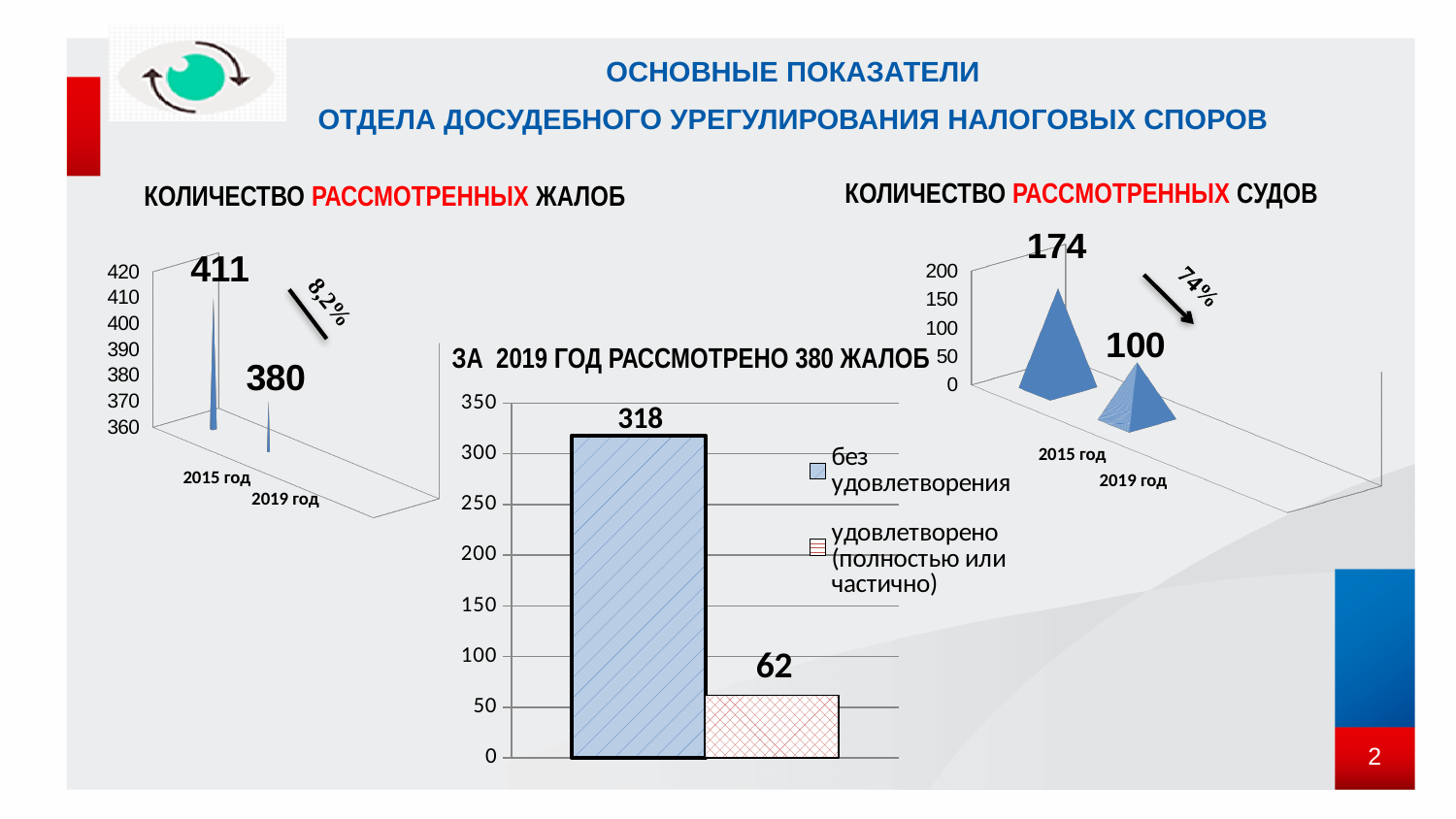
In the chart 'КОЛИЧЕСТВО РАССМОТРЕННЫХ ЖАЛОБ', what is the value for 2019 год? 380 What kind of chart is 'ЗА 2019 ГОД РАССМОТРЕНО 380 ЖАЛОБ'? bar chart In the chart 'КОЛИЧЕСТВО РАССМОТРЕННЫХ ЖАЛОБ', do the values rise or fall from 2015 год to 2019 год? fall In the chart 'ЗА 2019 ГОД РАССМОТРЕНО 380 ЖАЛОБ', how many series does the legend list? 2 In the chart 'ЗА 2019 ГОД РАССМОТРЕНО 380 ЖАЛОБ', what is the value for 'удовлетворено (полностью или частично)'? 62 In the chart 'КОЛИЧЕСТВО РАССМОТРЕННЫХ СУДОВ', what is the value for 2019 год? 100 In the chart 'КОЛИЧЕСТВО РАССМОТРЕННЫХ СУДОВ', what is the difference between the 2015 год and 2019 год values? 74 In the chart 'ЗА 2019 ГОД РАССМОТРЕНО 380 ЖАЛОБ', what is the value for 'без удовлетворения'? 318 In the chart 'КОЛИЧЕСТВО РАССМОТРЕННЫХ СУДОВ', which year has the higher value? 2015 год In the chart 'КОЛИЧЕСТВО РАССМОТРЕННЫХ ЖАЛОБ', what is the value for 2015 год? 411 In the chart 'КОЛИЧЕСТВО РАССМОТРЕННЫХ СУДОВ', what is the value for 2015 год? 174 In the chart 'КОЛИЧЕСТВО РАССМОТРЕННЫХ ЖАЛОБ', what is the difference between the 2015 год and 2019 год values? 31